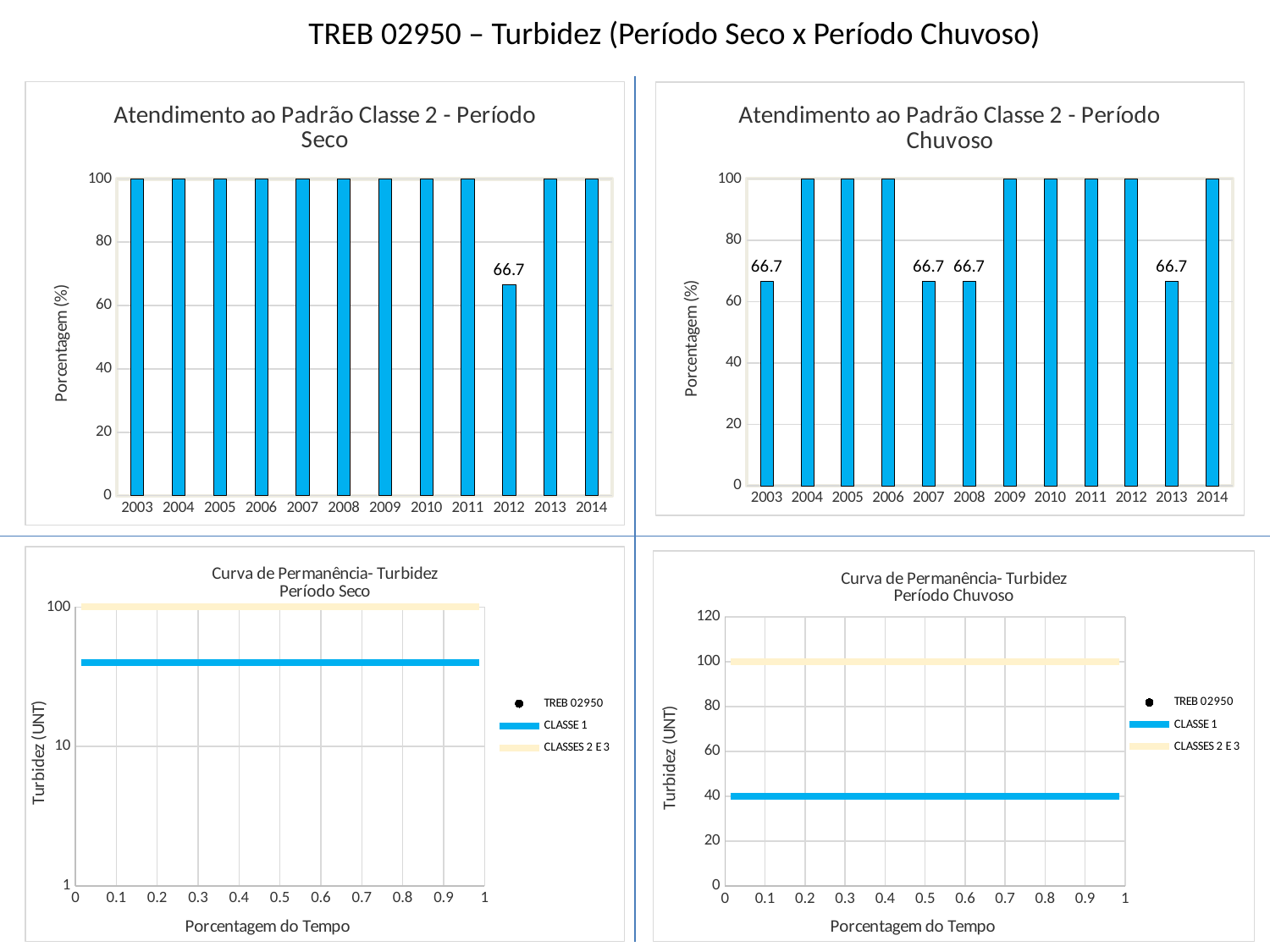
In the 'Atendimento ao Padrão Classe 2 - Período Chuvoso' chart, what is the difference between the values for 2009 and 2008? 33.3 In the 'Atendimento ao Padrão Classe 2 - Período Chuvoso' chart, which is larger, the value for 2003 or the value for 2006? 2006 In the 'Atendimento ao Padrão Classe 2 - Período Chuvoso' chart, what is the value for 2007? 66.7 In the 'Atendimento ao Padrão Classe 2 - Período Seco' chart, how many years are shown on the x axis? 12 In the 'Atendimento ao Padrão Classe 2 - Período Seco' chart, is the value for 2012 greater or less than 80? less In the 'Atendimento ao Padrão Classe 2 - Período Seco' chart, what is the value for 2012? 66.7 What kind of chart is 'Atendimento ao Padrão Classe 2 - Período Seco'? bar chart In the 'Curva de Permanência- Turbidez Período Chuvoso' chart, what is the y-axis label? Turbidez (UNT) In the 'Atendimento ao Padrão Classe 2 - Período Seco' chart, which year has the lowest value? 2012 In the 'Curva de Permanência- Turbidez Período Chuvoso' chart, how many series does the legend list? 3 In the 'Atendimento ao Padrão Classe 2 - Período Chuvoso' chart, how many years have a value of 66.7? 4 In the 'Atendimento ao Padrão Classe 2 - Período Chuvoso' chart, what is the value for 2004? 100